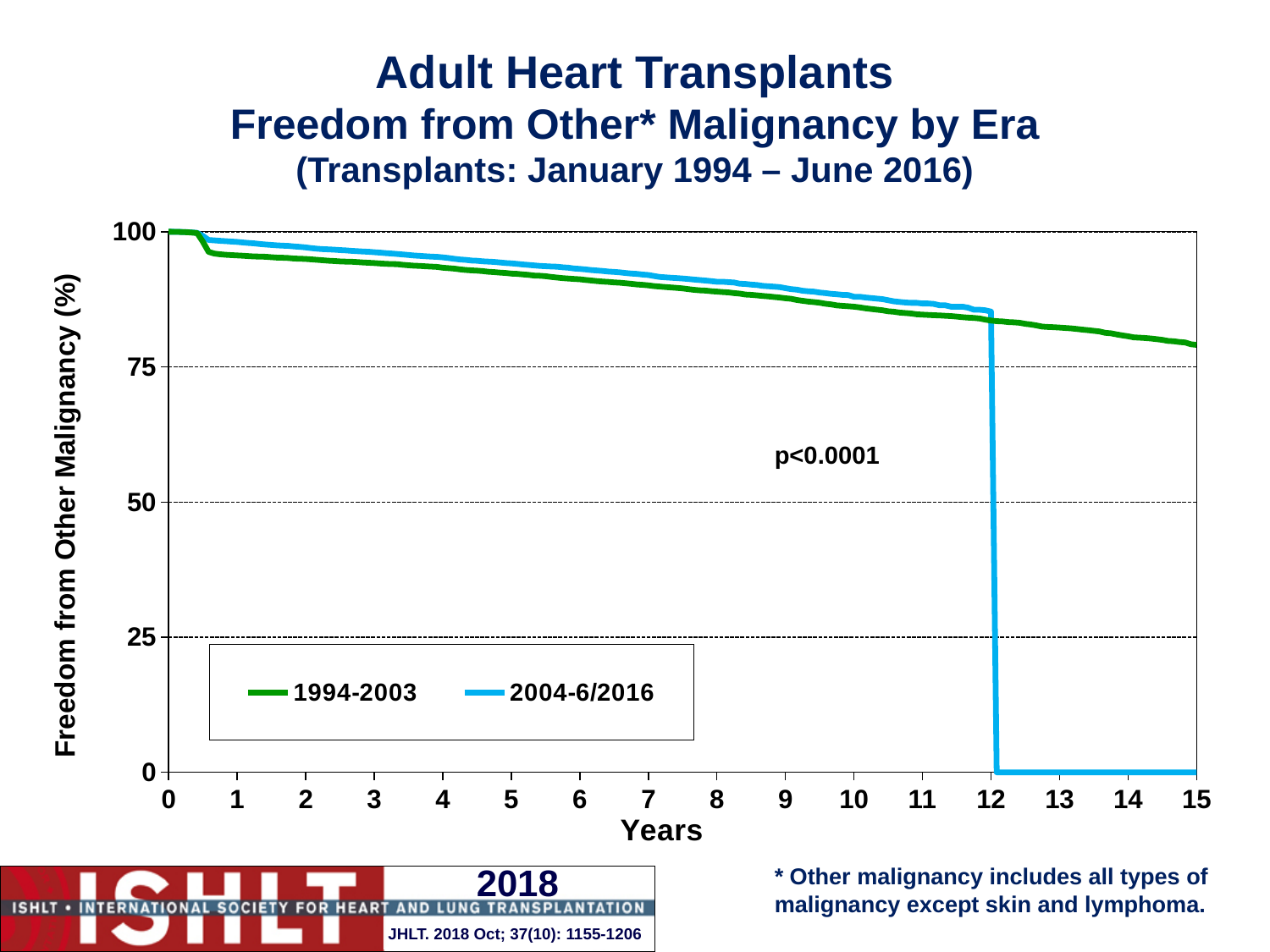
Does the 1994-2003 curve rise or fall as years increase? fall Is the value for the 1994-2003 era at year 15 greater or less than 75? greater What is the label of the y axis? Freedom from Other Malignancy (%) Is the value for the 2004-6/2016 era at year 13 greater or less than 25? less What is the freedom from other malignancy for both eras at year 0? 100 What kind of chart is shown on the slide? line chart At year 5, which era has the higher freedom from other malignancy? 2004-6/2016 Which two eras are listed in the legend? 1994-2003 and 2004-6/2016 How many series does the legend list? 2 Is the value for the 2004-6/2016 era at year 10 greater or less than 75? greater At year 14, which era has the higher freedom from other malignancy? 1994-2003 What p-value is printed on the chart? p<0.0001